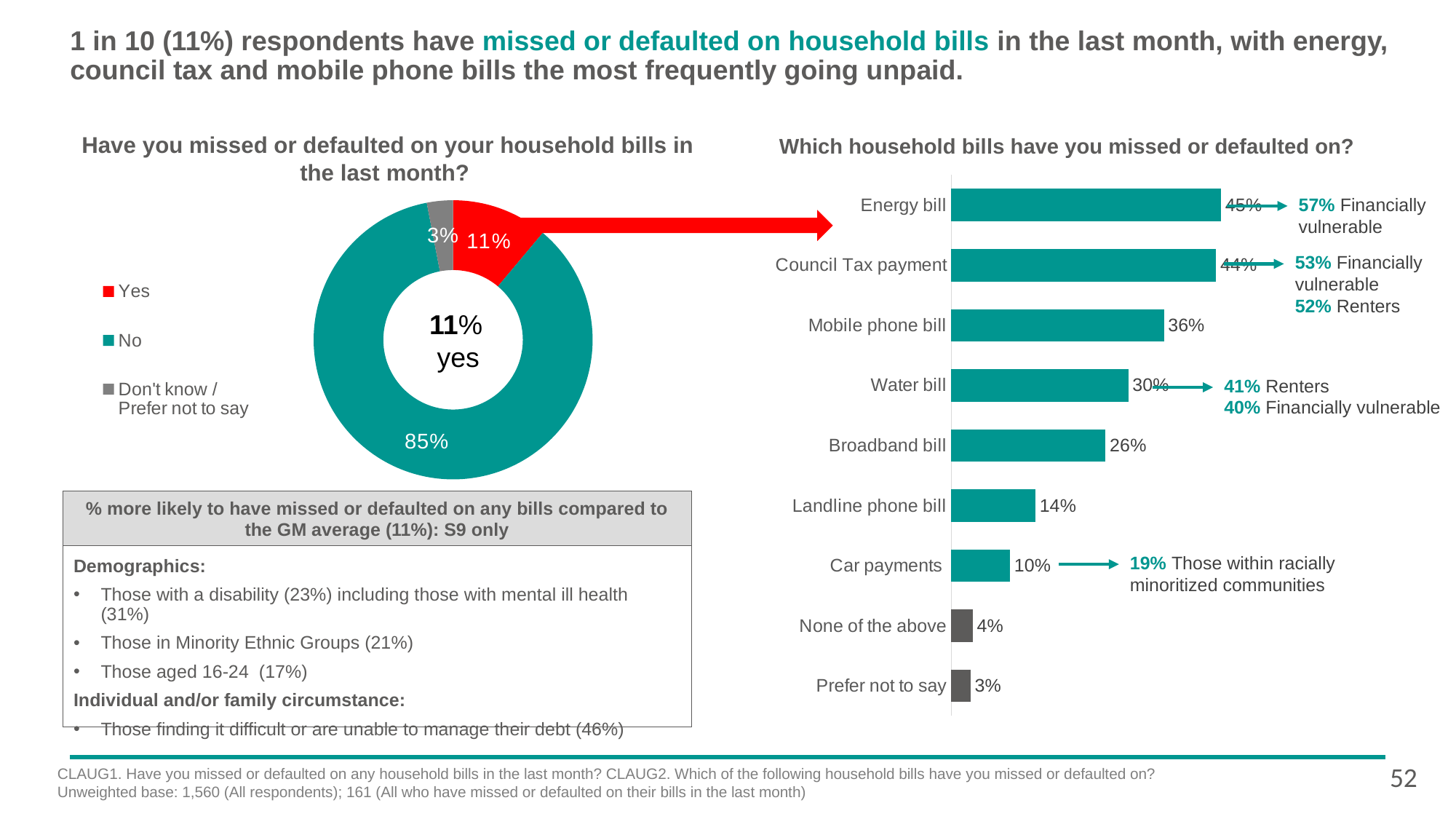
How many categories does the legend of the chart 'Have you missed or defaulted on your household bills in the last month?' list? 3 In the chart 'Have you missed or defaulted on your household bills in the last month?', what share of respondents answered 'Don't know / Prefer not to say'? 3% In the chart 'Have you missed or defaulted on your household bills in the last month?', what percentage of respondents answered Yes? 11% How many categories are shown in the chart 'Which household bills have you missed or defaulted on?'? 9 In the chart 'Which household bills have you missed or defaulted on?', what is the value for Mobile phone bill? 36% In the chart 'Which household bills have you missed or defaulted on?', which category has the lowest value? Prefer not to say In the chart 'Which household bills have you missed or defaulted on?', which is larger: Car payments or Landline phone bill? Landline phone bill In the chart 'Which household bills have you missed or defaulted on?', what is the value for Broadband bill? 26% In the chart 'Which household bills have you missed or defaulted on?', what is the difference between the values for Water bill and Landline phone bill? 16 percentage points What kind of chart is 'Have you missed or defaulted on your household bills in the last month?'? Pie (donut) chart In the chart 'Which household bills have you missed or defaulted on?', which bill has the highest value? Energy bill In the chart 'Have you missed or defaulted on your household bills in the last month?', what percentage of respondents answered No? 85%